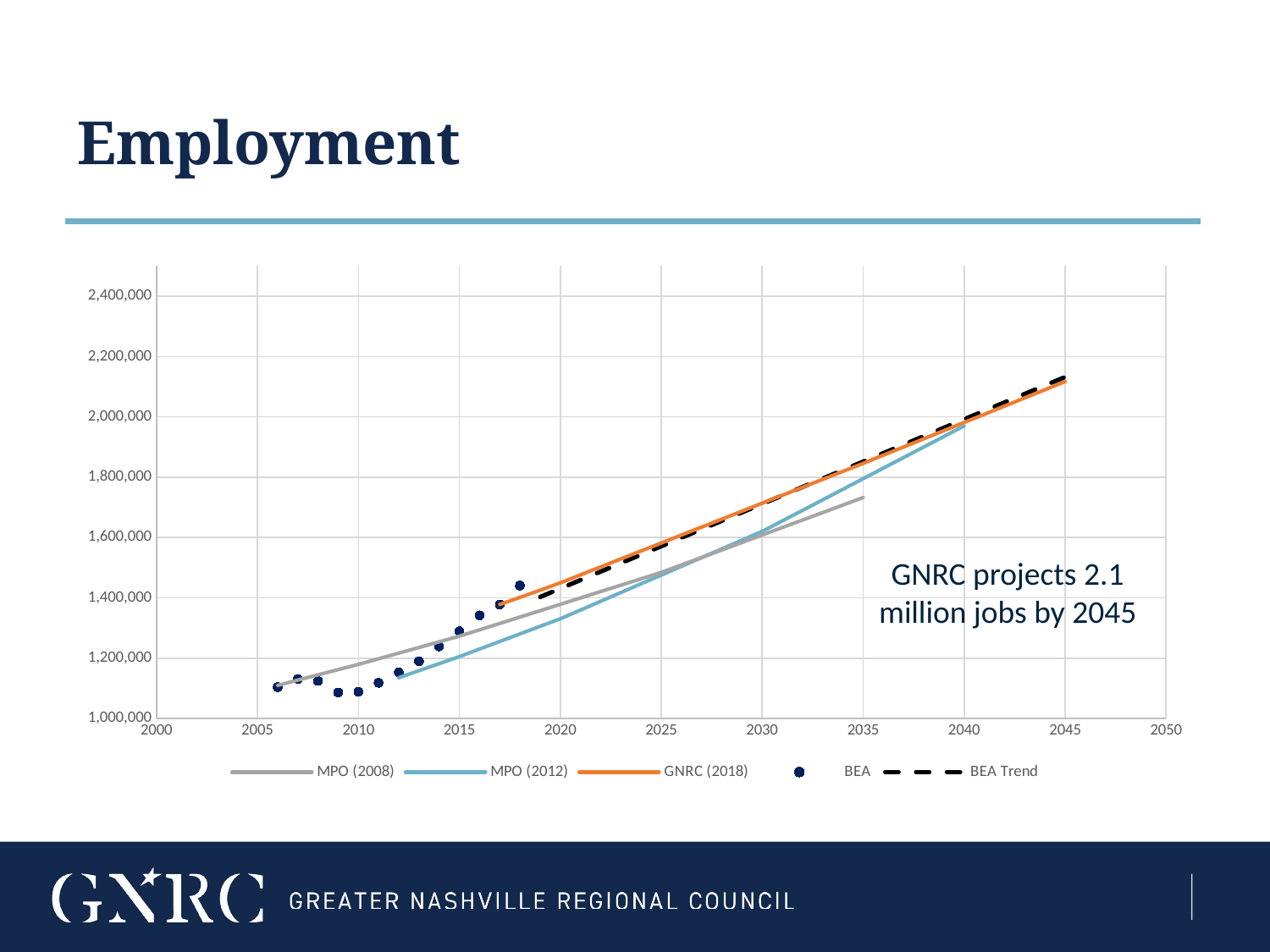
Do the GNRC (2018) values rise or fall from 2017 to 2045? rise At 2025, which is higher: GNRC (2018) or MPO (2012)? GNRC (2018) Which series in the legend is drawn as a dashed line? BEA Trend What is the title of the slide containing the chart? Employment Is the MPO (2008) value at 2035 greater or less than 1,800,000? less At 2035, which is higher: MPO (2012) or MPO (2008)? MPO (2012) Is the BEA value at 2010 greater or less than 1,200,000? less Is the MPO (2012) value at 2020 greater or less than 1,200,000? greater What kind of chart is shown on the slide? line chart How many series does the legend list? 5 At 2030, which is higher: GNRC (2018) or MPO (2008)? GNRC (2018)